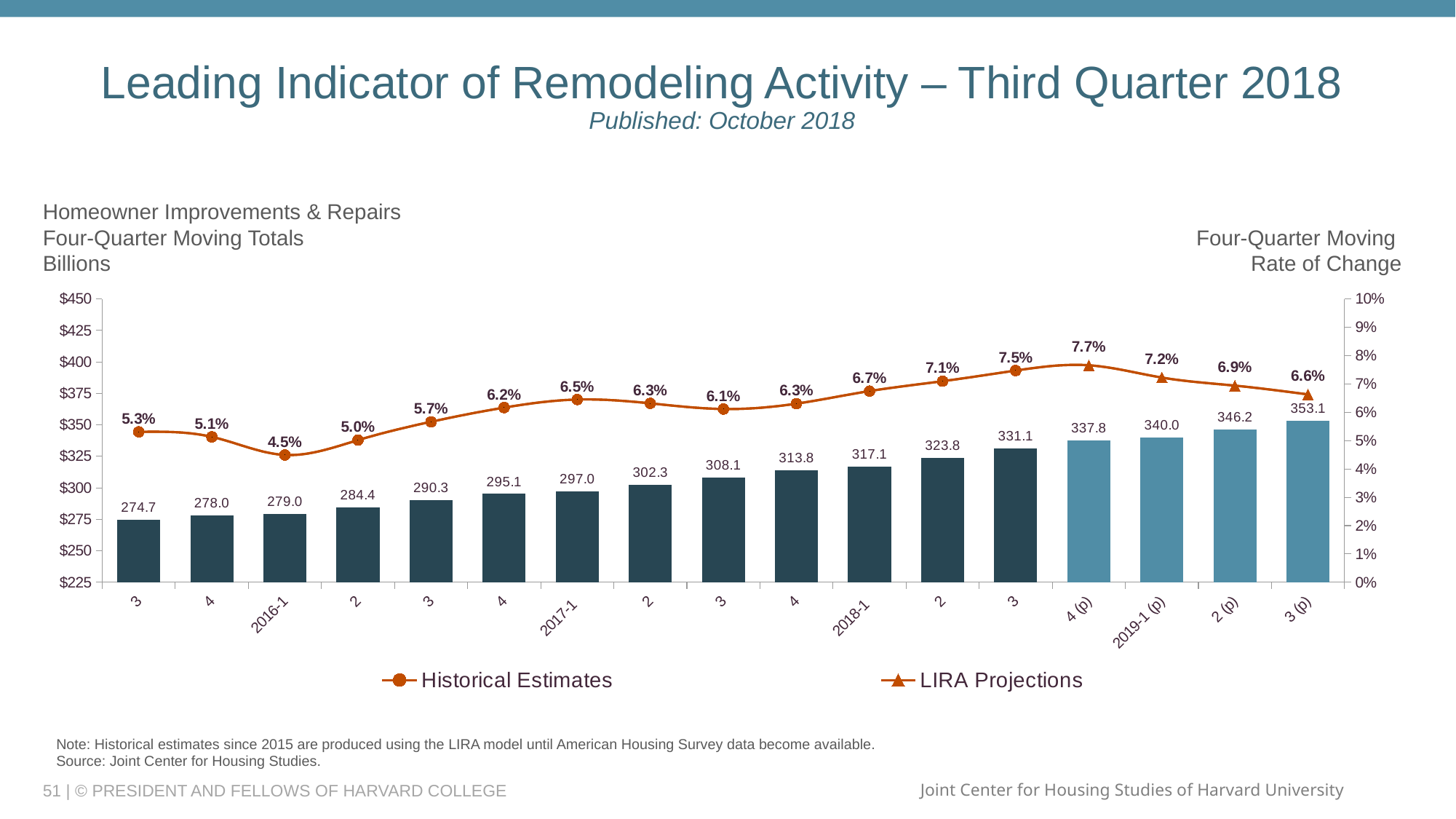
Which quarter has the highest four-quarter moving total? 3 (p) How many quarters are shown on the x axis? 17 Which quarter has the highest four-quarter moving rate of change? 4 (p) What is the difference in four-quarter moving totals between 3 (p) and 2019-1 (p)? 13.1 Which quarter has the lowest four-quarter moving rate of change? 2016-1 What is the four-quarter moving total (in billions) for 2018-1? 317.1 What is the four-quarter moving rate of change for 2017-1? 6.5% What is the four-quarter moving rate of change for 2019-1 (p)? 7.2% Which has a higher rate of change, 2018-1 or 2 (p)? 2 (p) Do the four-quarter moving totals rise or fall from left to right along the x axis? rise How many series does the legend list? 2 What is the four-quarter moving total (in billions) for 2016-1? 279.0